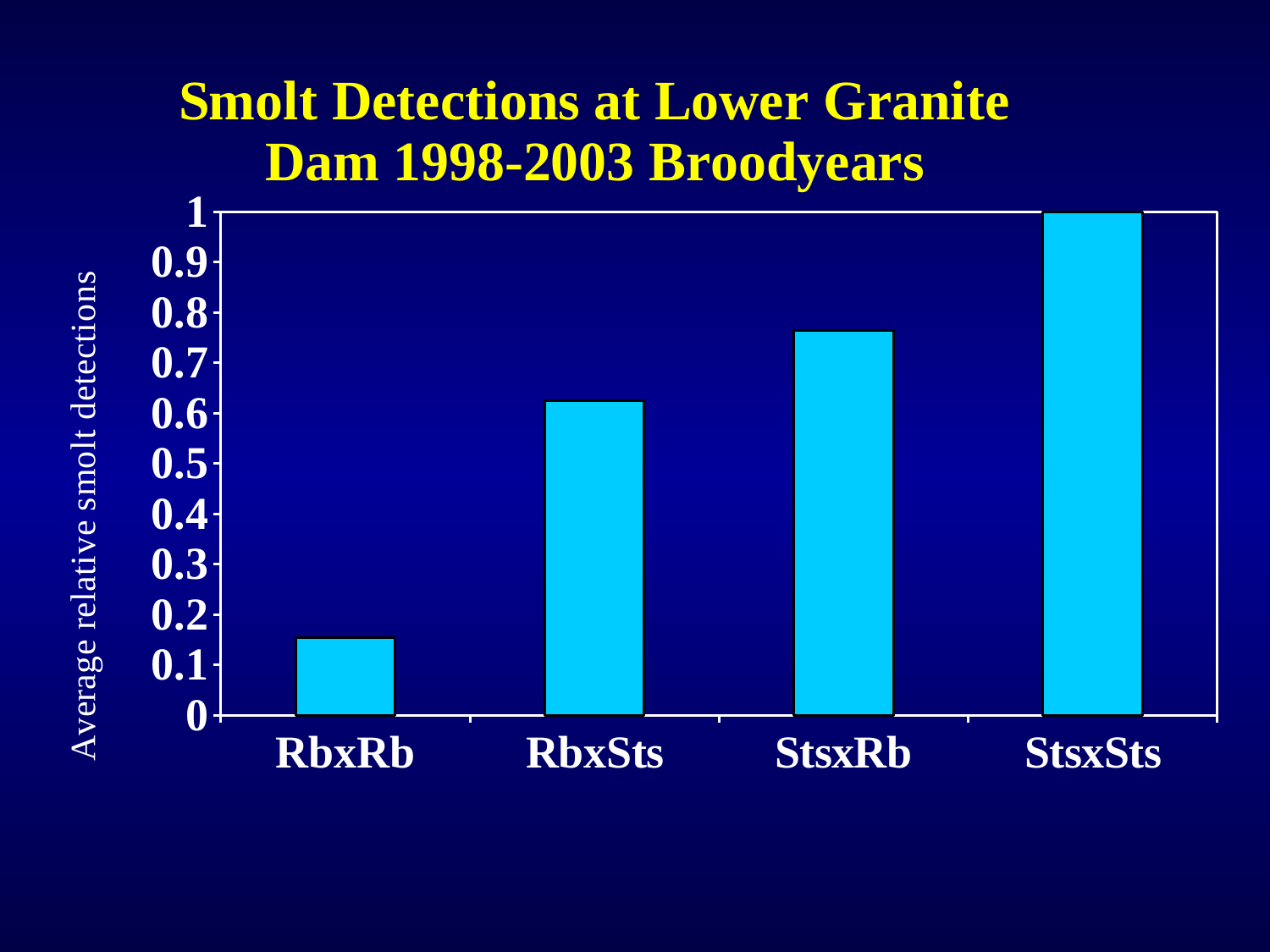
Which category has the lowest average relative smolt detections? RbxRb What is the average relative smolt detections value for StsxSts? 1 Is the value for RbxSts greater or less than 0.5? greater How many categories are shown on the x axis of the chart? 4 Do the values rise or fall moving from RbxRb to StsxSts along the x axis? rise Which category has the highest average relative smolt detections? StsxSts Which is larger, the value for RbxSts or the value for StsxRb? StsxRb Is the value for StsxRb greater or less than 0.8? less Is the value for RbxRb greater or less than 0.2? less What is the label of the y axis? Average relative smolt detections What kind of chart is shown on the slide? bar chart What is the title of the chart? Smolt Detections at Lower Granite Dam 1998-2003 Broodyears